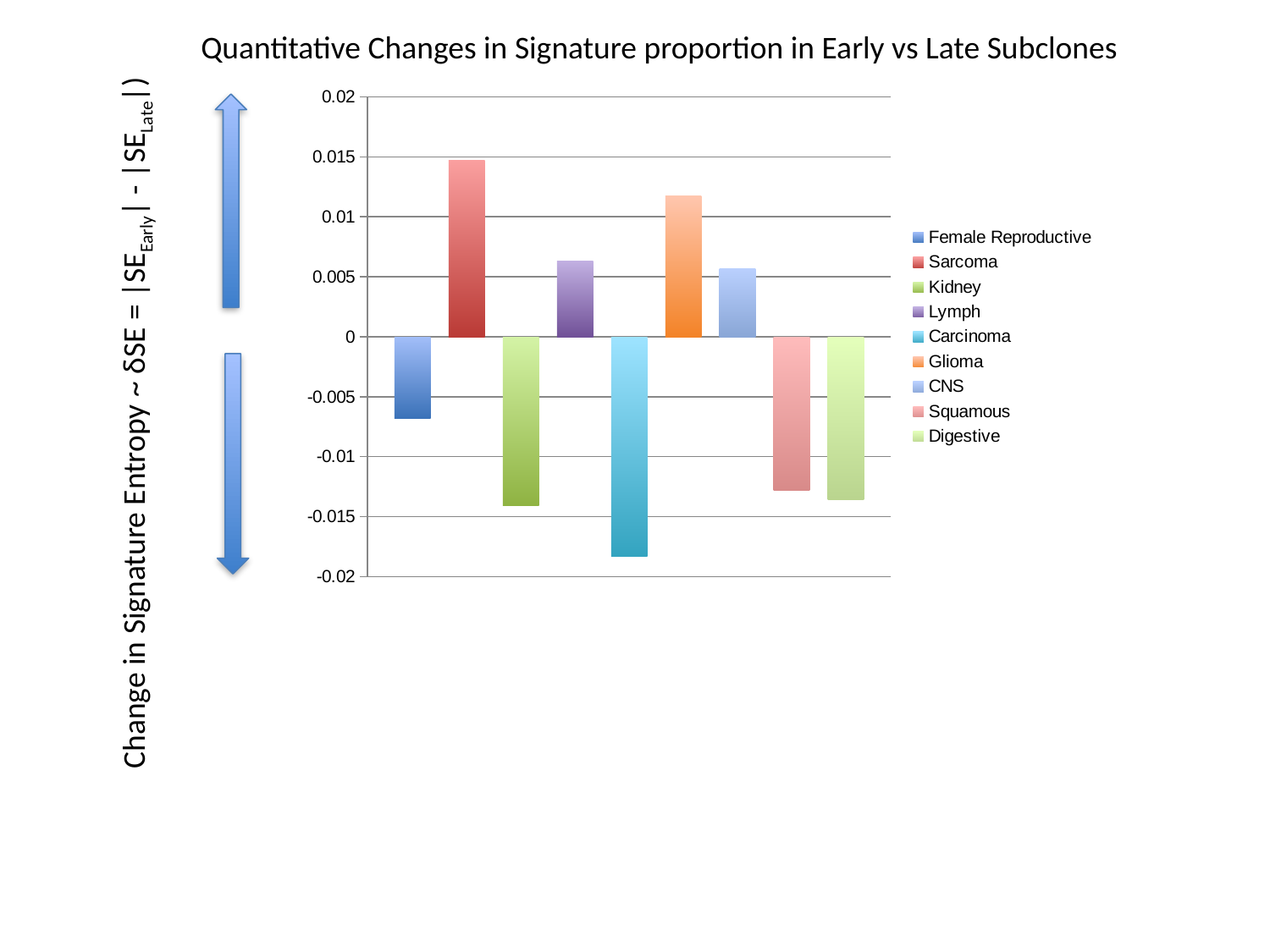
Is the value for Kidney greater or less than -0.01? less How many series does the legend list? 9 Which is larger, the value for Sarcoma or the value for Glioma? Sarcoma Is the value for Female Reproductive greater or less than -0.005? less Which category has the lowest value? Carcinoma How many bars are plotted in the chart? 9 What is the title of the chart? Quantitative Changes in Signature proportion in Early vs Late Subclones Is the value for Sarcoma greater or less than 0.01? greater Which is larger, the value for Female Reproductive or the value for Squamous? Female Reproductive Which category has the highest value? Sarcoma What kind of chart is shown on the slide? bar chart